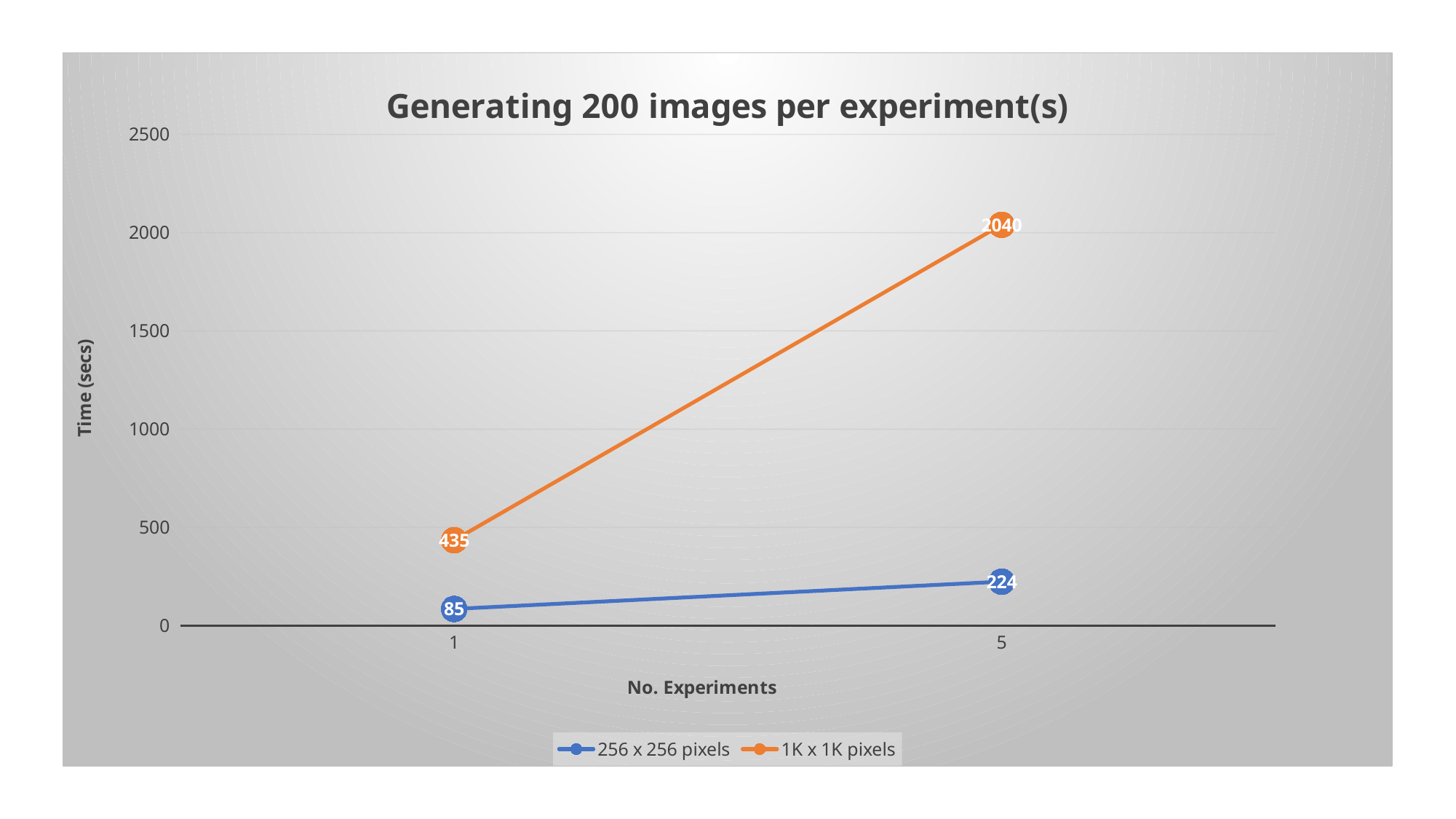
What is the time in seconds for 1K x 1K pixels at 1 experiment? 435 What is the difference between the 1K x 1K pixels and 256 x 256 pixels times at 5 experiments? 1816 What is the time in seconds for 256 x 256 pixels at 1 experiment? 85 Is the value for 1K x 1K pixels at 5 experiments greater or less than 1500? greater How many series does the legend list? 2 What is the time in seconds for 1K x 1K pixels at 5 experiments? 2040 What kind of chart is shown? line chart What is the difference between the 1K x 1K pixels times at 5 experiments and at 1 experiment? 1605 Which is larger: the 1K x 1K pixels time at 1 experiment or the 256 x 256 pixels time at 5 experiments? 1K x 1K pixels at 1 experiment Which series has the highest value at 5 experiments? 1K x 1K pixels Does the 256 x 256 pixels series rise or fall from 1 to 5 experiments? rise What is the time in seconds for 256 x 256 pixels at 5 experiments? 224